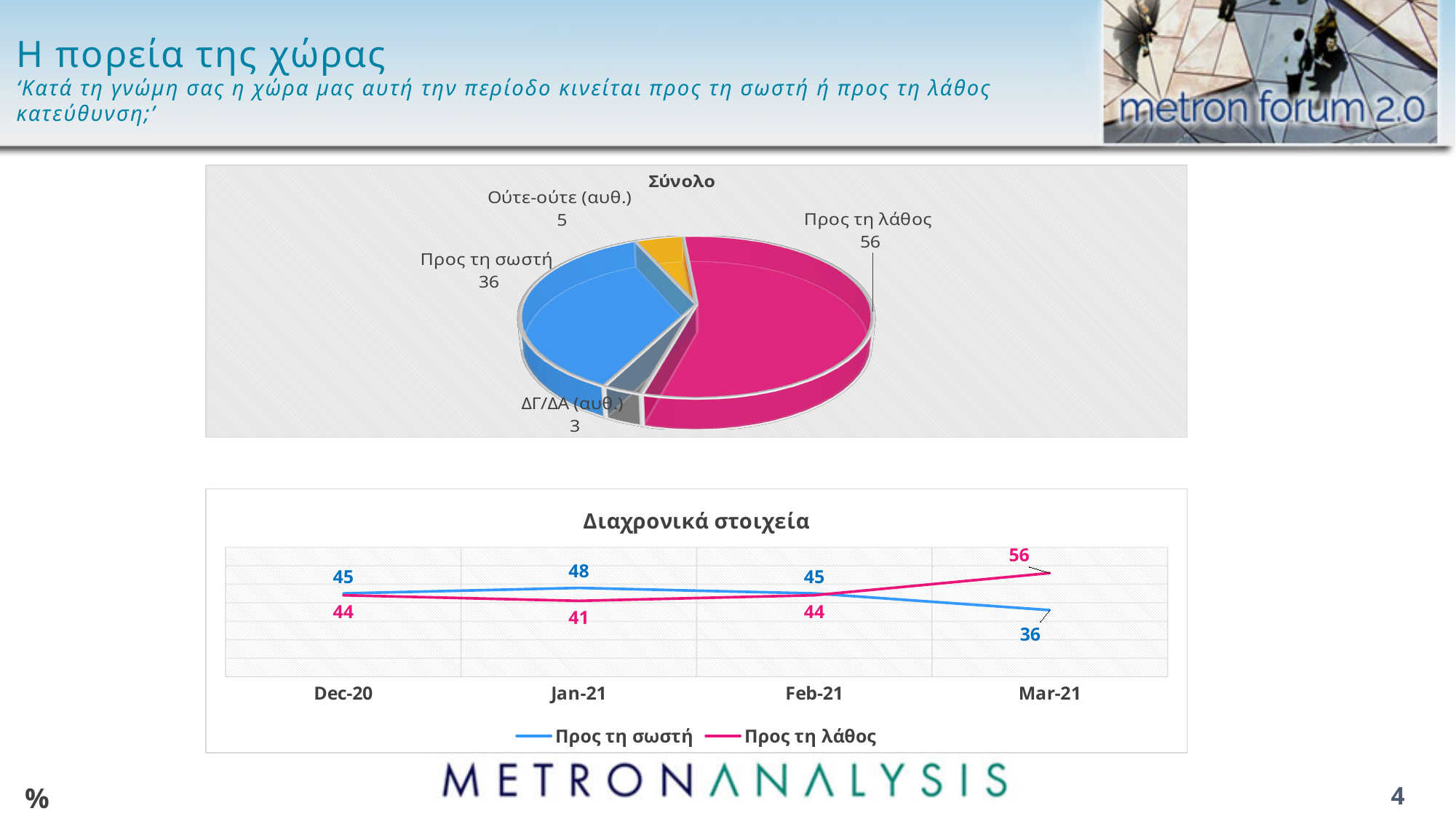
In the chart titled 'Διαχρονικά στοιχεία', does 'Προς τη σωστή' rise or fall from Feb-21 to Mar-21? Fall In the pie chart titled 'Σύνολο', what is the value for 'Προς τη λάθος'? 56 In the chart titled 'Διαχρονικά στοιχεία', in which month does 'Προς τη λάθος' reach its highest value? Mar-21 In the chart titled 'Διαχρονικά στοιχεία', which is larger in Dec-20: 'Προς τη σωστή' or 'Προς τη λάθος'? Προς τη σωστή In the chart titled 'Διαχρονικά στοιχεία', what is the value for 'Προς τη λάθος' in Feb-21? 44 In the chart titled 'Διαχρονικά στοιχεία', what is the value for 'Προς τη σωστή' in Jan-21? 48 What kind of chart is the chart titled 'Διαχρονικά στοιχεία'? Line chart In the pie chart titled 'Σύνολο', how many slices are there? 4 In the pie chart titled 'Σύνολο', what is the difference between 'Προς τη λάθος' and 'Προς τη σωστή'? 20 In the chart titled 'Διαχρονικά στοιχεία', how many series does the legend list? 2 In the pie chart titled 'Σύνολο', which category has the smallest slice? ΔΓ/ΔΑ (αυθ.) In the pie chart titled 'Σύνολο', what is the value for 'Ούτε-ούτε (αυθ.)'? 5